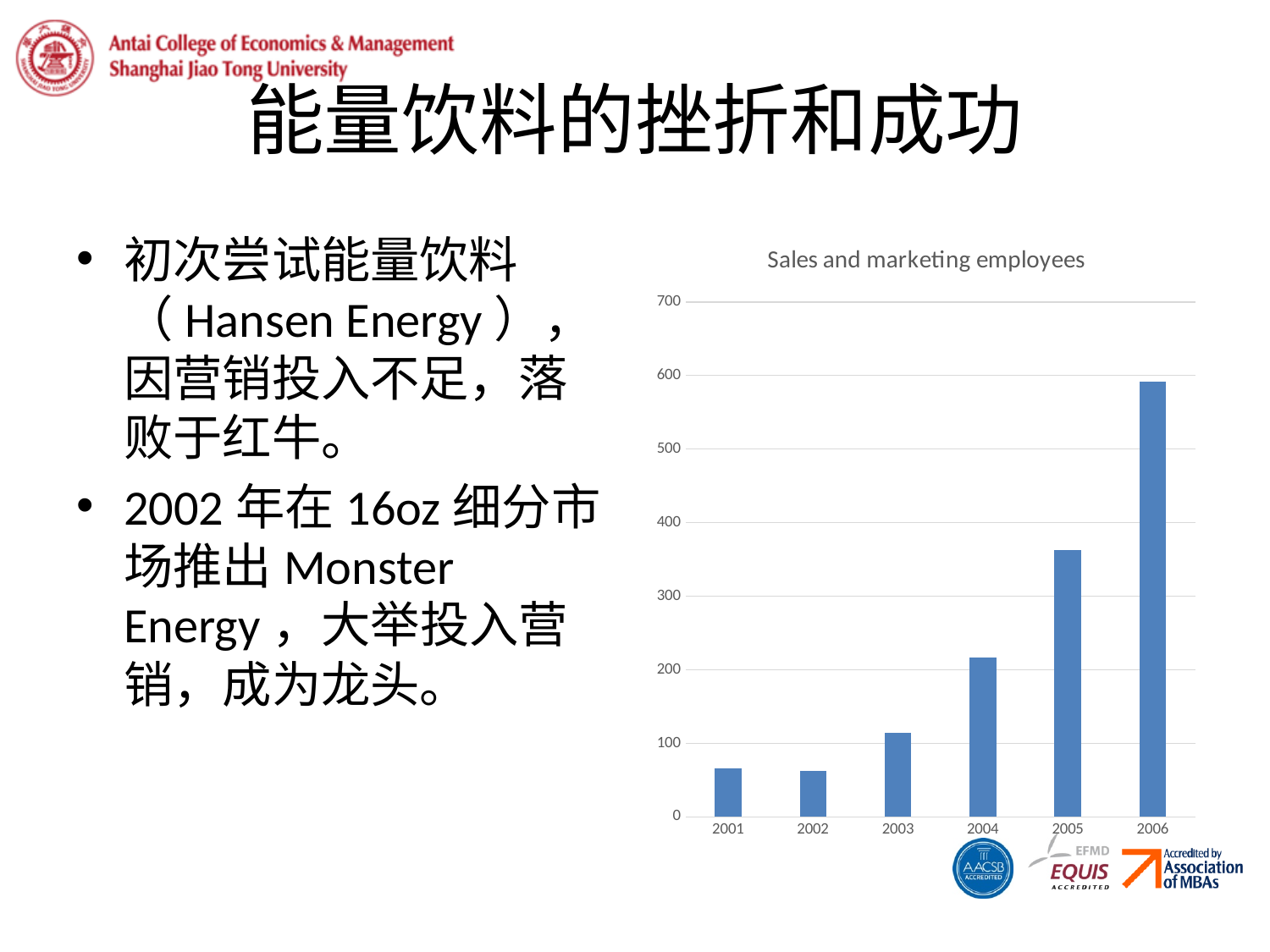
Which is larger, the value for 2003 or the value for 2002? 2003 Is the value for 2004 greater or less than 300? less Is the value for 2001 greater or less than 100? less How many years are shown on the x axis of the chart? 6 Do the values generally rise or fall from 2002 to 2006? rise What is the title of the chart? Sales and marketing employees Is the value for 2005 greater or less than 300? greater Which is larger, the value for 2005 or the value for 2004? 2005 What kind of chart is shown on the slide? bar chart Which year has the highest number of sales and marketing employees? 2006